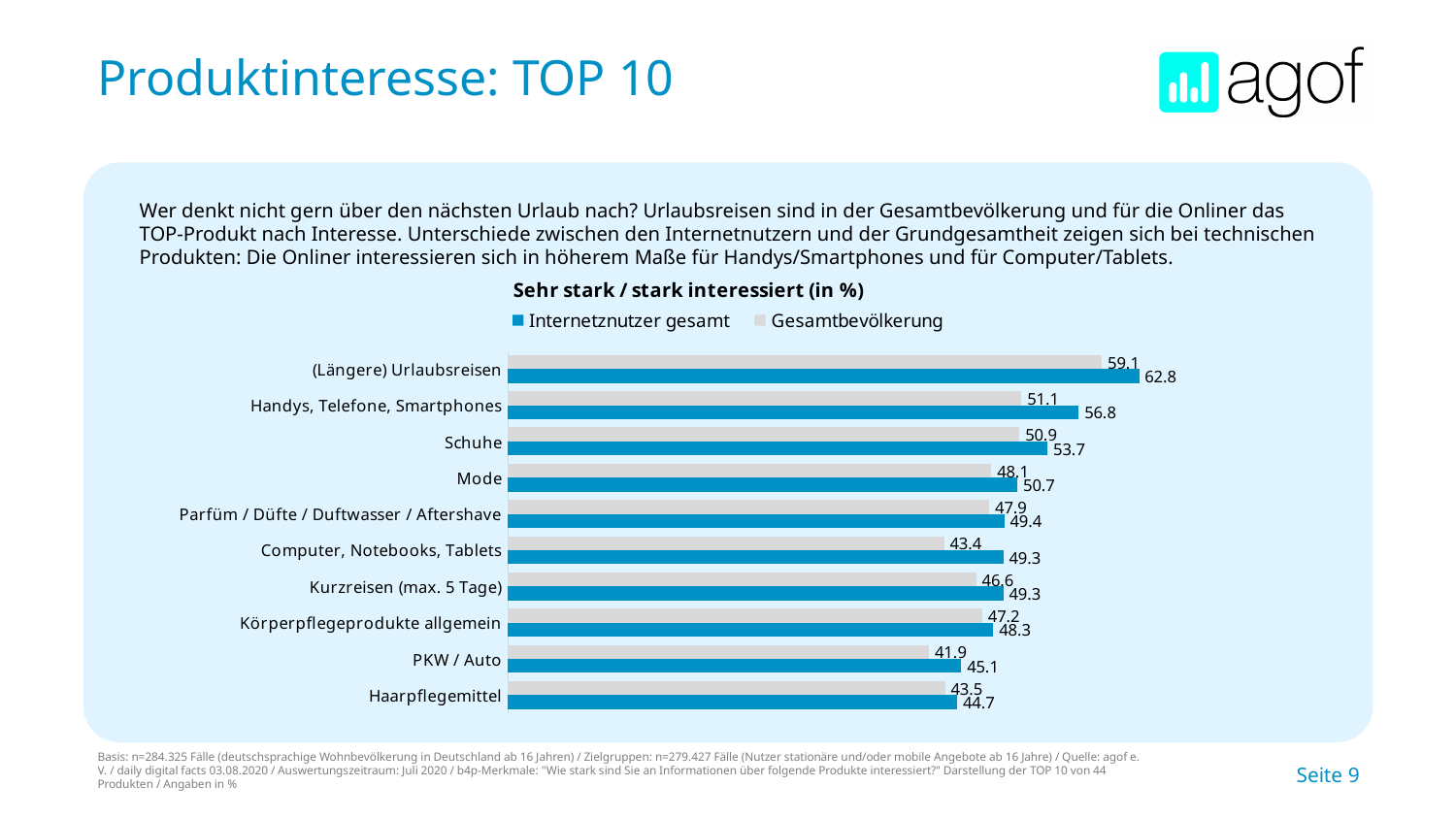
What is the value for Gesamtbevölkerung for Handys, Telefone, Smartphones? 51,1 Which category has the lowest value for Gesamtbevölkerung? PKW / Auto Which category has the highest value for Internetnutzer gesamt? (Längere) Urlaubsreisen What is the title of the chart? Sehr stark / stark interessiert (in %) What is the difference between Internetnutzer gesamt and Gesamtbevölkerung for Computer, Notebooks, Tablets? 5,9 What is the value for Internetnutzer gesamt for Computer, Notebooks, Tablets? 49,3 What type of chart is shown on the slide? bar chart What is the value for Internetnutzer gesamt for (Längere) Urlaubsreisen? 62,8 Which is larger for Schuhe: the value for Internetnutzer gesamt or for Gesamtbevölkerung? Internetnutzer gesamt What is the value for Gesamtbevölkerung for PKW / Auto? 41,9 How many series does the chart legend list? 2 How many product categories are shown in the chart? 10